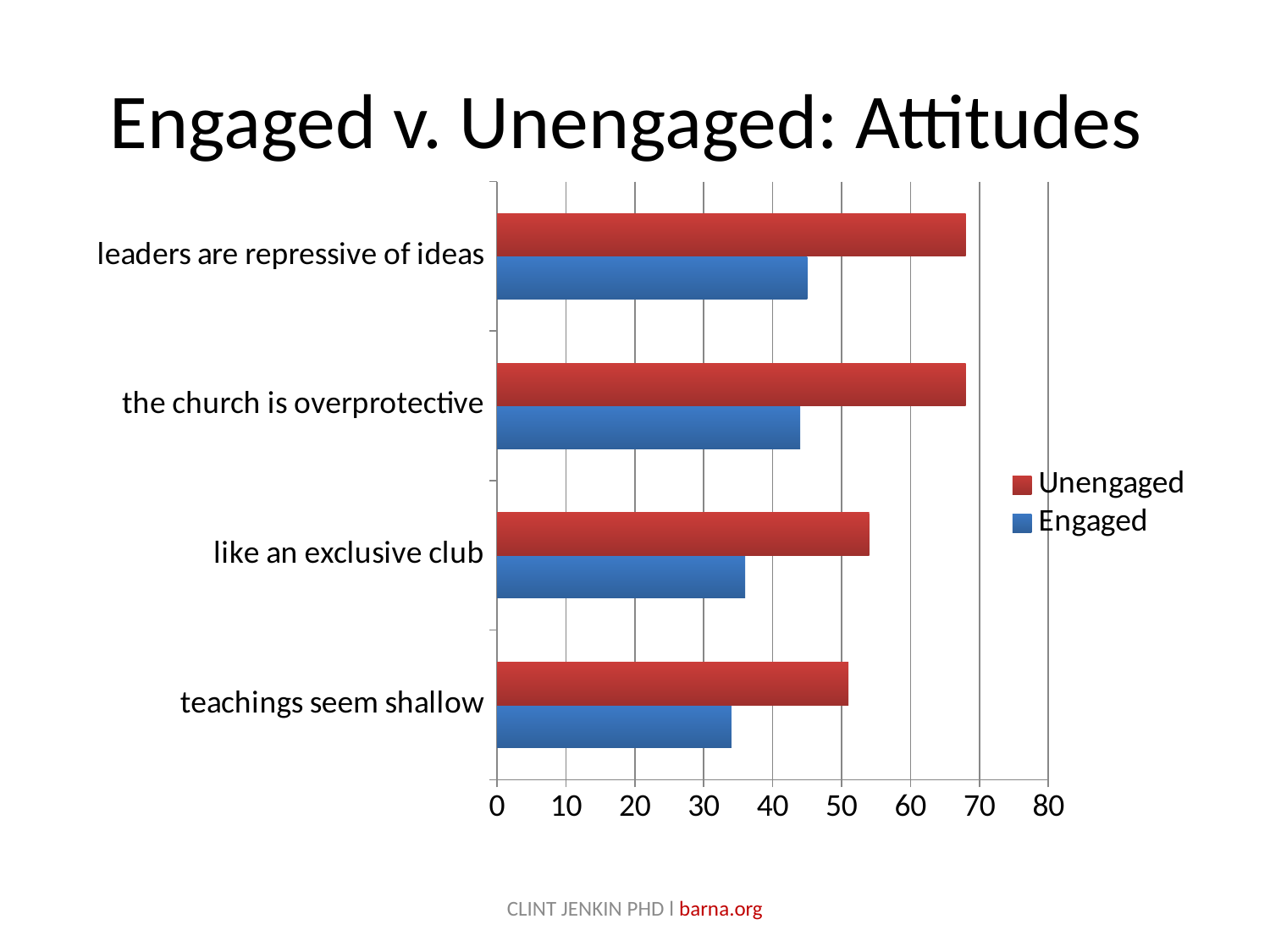
Is the Unengaged value for 'the church is overprotective' greater or less than 60? greater Is the Unengaged value for 'like an exclusive club' greater or less than 50? greater For 'the church is overprotective', which series has the larger value, Unengaged or Engaged? Unengaged For 'teachings seem shallow', which series has the smaller value, Unengaged or Engaged? Engaged What is the title of the chart? Engaged v. Unengaged: Attitudes Is the Engaged value for 'like an exclusive club' greater or less than 40? less How many series does the legend list? 2 Which series is shown in red? Unengaged How many attitude categories are shown on the chart? 4 What kind of chart is shown on the slide? bar chart